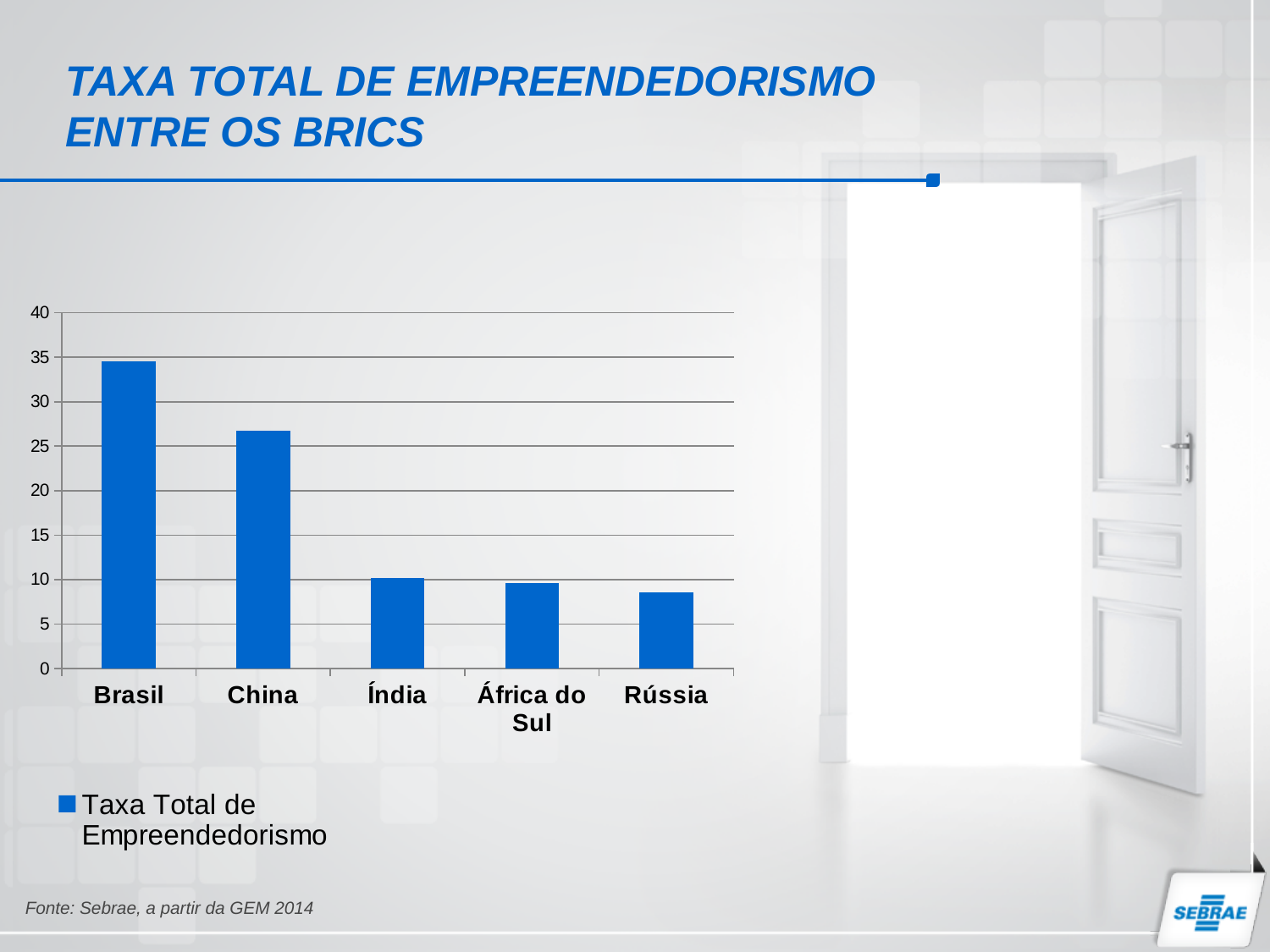
Which country has the lowest Taxa Total de Empreendedorismo? Rússia How many series does the chart's legend list? 1 Which country has the highest Taxa Total de Empreendedorismo? Brasil Which has a higher Taxa Total de Empreendedorismo, Brasil or China? Brasil Is the value for Rússia greater or less than 10? less Is the value for Brasil greater or less than 30? greater Do the values rise or fall moving from Brasil to Rússia along the x axis? fall Is the value for China greater or less than 30? less How many countries are shown on the x axis of the chart? 5 What series name is shown in the chart's legend? Taxa Total de Empreendedorismo Which has a higher Taxa Total de Empreendedorismo, China or Índia? China What kind of chart is shown on the slide? bar chart